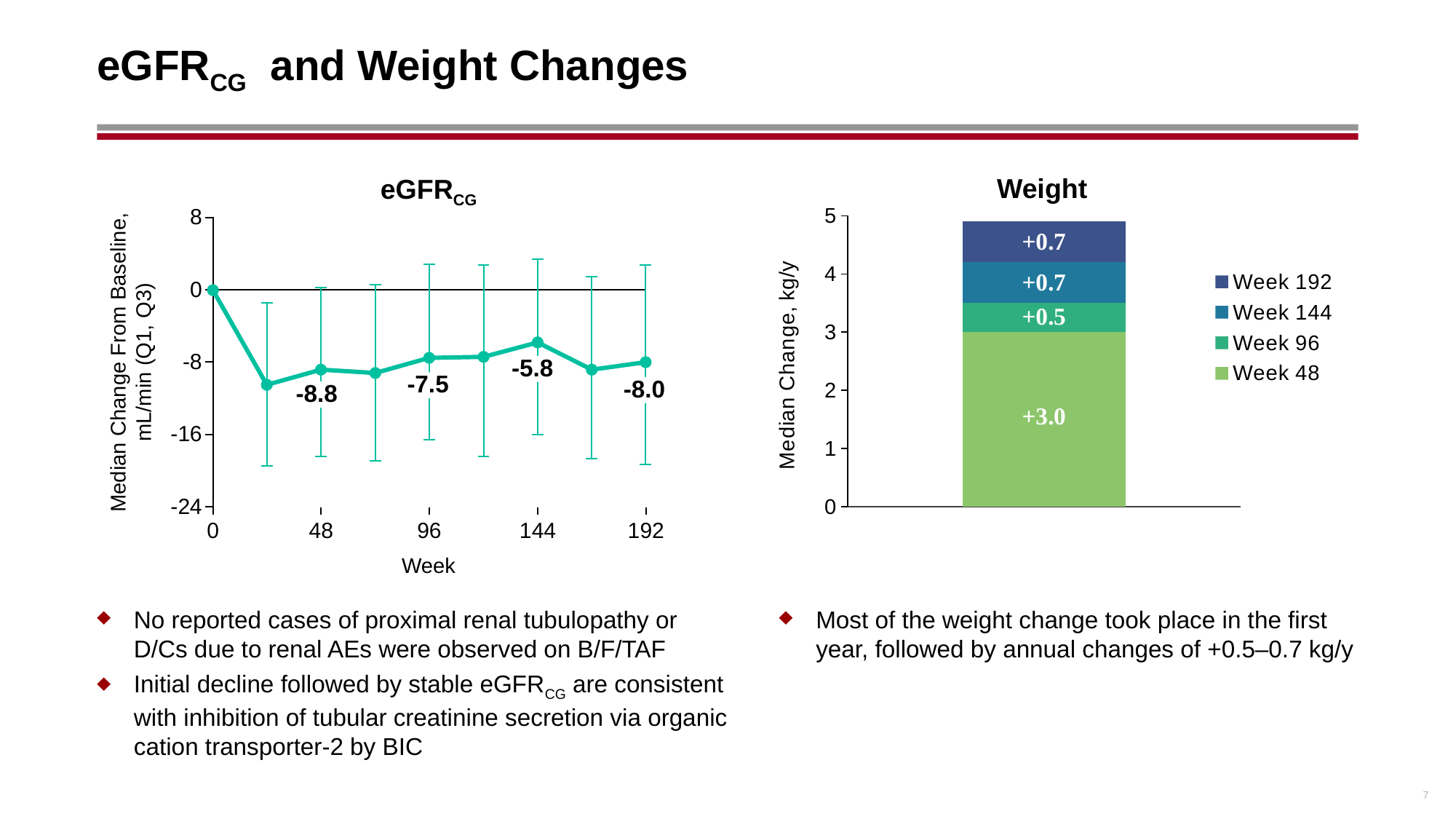
What kind of chart is the eGFR_CG chart? Line chart In the eGFR_CG chart, is the median change at week 24 greater or less than -8? less In the eGFR_CG chart, what is the median change from baseline at week 48? -8.8 In the eGFR_CG chart, what is the median change from baseline at week 144? -5.8 In the eGFR_CG chart, what is the median change from baseline at week 192? -8.0 In the Weight chart, how many series does the legend list? 4 What kind of chart is the Weight chart? Stacked bar chart In the eGFR_CG chart, what is the difference between the values at week 48 and week 144? 3.0 In the Weight chart, what is the median change for Week 96? +0.5 In the Weight chart, what is the total of the stacked bar? 4.9 In the Weight chart, which segment is larger, Week 48 or Week 192? Week 48 In the Weight chart, what is the median change for Week 48? +3.0